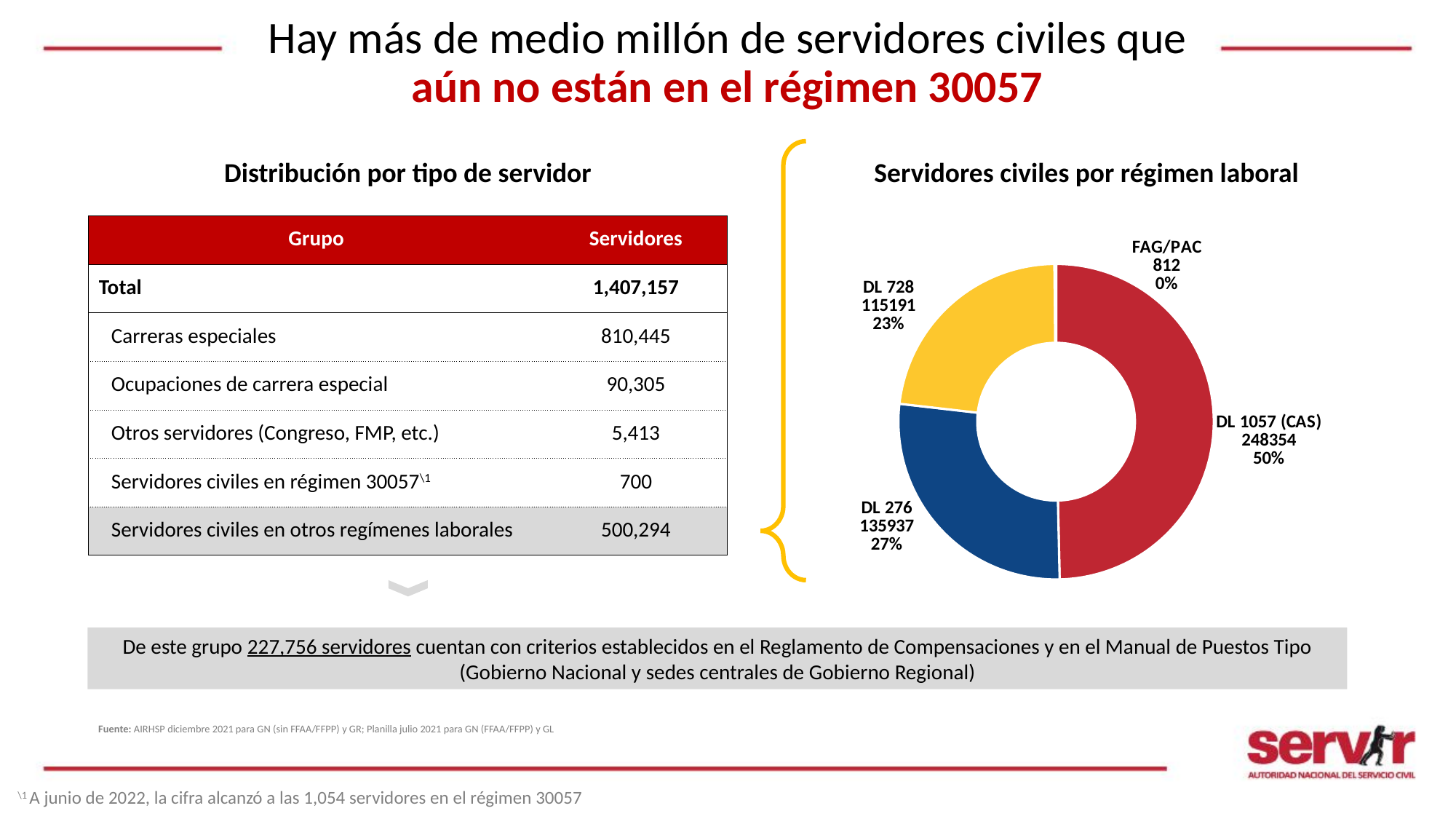
How many slices does the chart 'Servidores civiles por régimen laboral' have? 4 In the chart 'Servidores civiles por régimen laboral', how many servidores are in DL 1057 (CAS)? 248354 In the chart 'Servidores civiles por régimen laboral', how many servidores are in FAG/PAC? 812 What kind of chart is 'Servidores civiles por régimen laboral'? pie (doughnut) chart In the chart 'Servidores civiles por régimen laboral', what percentage share does DL 728 have? 23% In the chart 'Servidores civiles por régimen laboral', which régimen has the smallest share? FAG/PAC In the chart 'Servidores civiles por régimen laboral', how many servidores are in DL 276? 135937 In the chart 'Servidores civiles por régimen laboral', how many servidores are in DL 728? 115191 In the chart 'Servidores civiles por régimen laboral', what is the difference between the DL 1057 (CAS) and DL 276 values? 112417 In the chart 'Servidores civiles por régimen laboral', what percentage share does DL 276 have? 27% In the chart 'Servidores civiles por régimen laboral', which is larger, DL 276 or DL 728? DL 276 In the chart 'Servidores civiles por régimen laboral', which régimen has the largest share? DL 1057 (CAS)